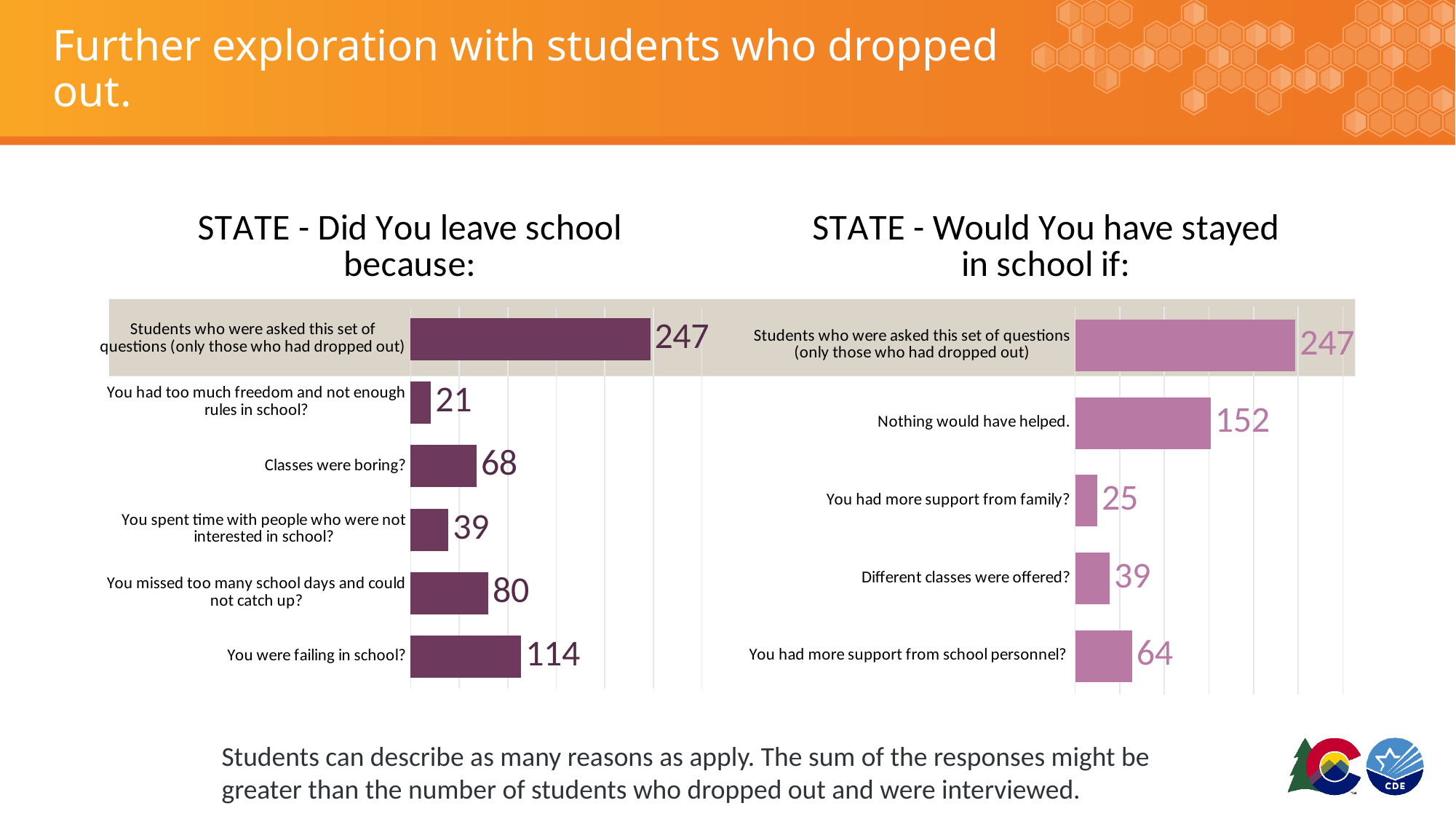
In the 'STATE - Would You have stayed in school if:' chart, what is the value for 'You had more support from school personnel?' 64 In the 'STATE - Did You leave school because:' chart, which reason (excluding the 'Students who were asked' row) has the lowest value? You had too much freedom and not enough rules in school? How many students were asked the set of questions in the 'STATE - Did You leave school because:' chart? 247 In the 'STATE - Did You leave school because:' chart, which is larger: 'Classes were boring?' or 'You spent time with people who were not interested in school?' Classes were boring? What type of chart is the 'STATE - Did You leave school because:' chart? Bar chart In the 'STATE - Did You leave school because:' chart, what is the value for 'Classes were boring?' 68 In the 'STATE - Did You leave school because:' chart, what is the difference between 'You were failing in school?' and 'You missed too many school days and could not catch up?' 34 In the 'STATE - Would You have stayed in school if:' chart, what is the difference between 'Nothing would have helped.' and 'You had more support from school personnel?' 88 In the 'STATE - Did You leave school because:' chart, what is the value for 'You were failing in school?' 114 In the 'STATE - Would You have stayed in school if:' chart, what is the value for 'Nothing would have helped.'? 152 In the 'STATE - Would You have stayed in school if:' chart, which option (excluding the 'Students who were asked' row) has the highest value? Nothing would have helped. How many bars are shown in the 'STATE - Would You have stayed in school if:' chart? 5